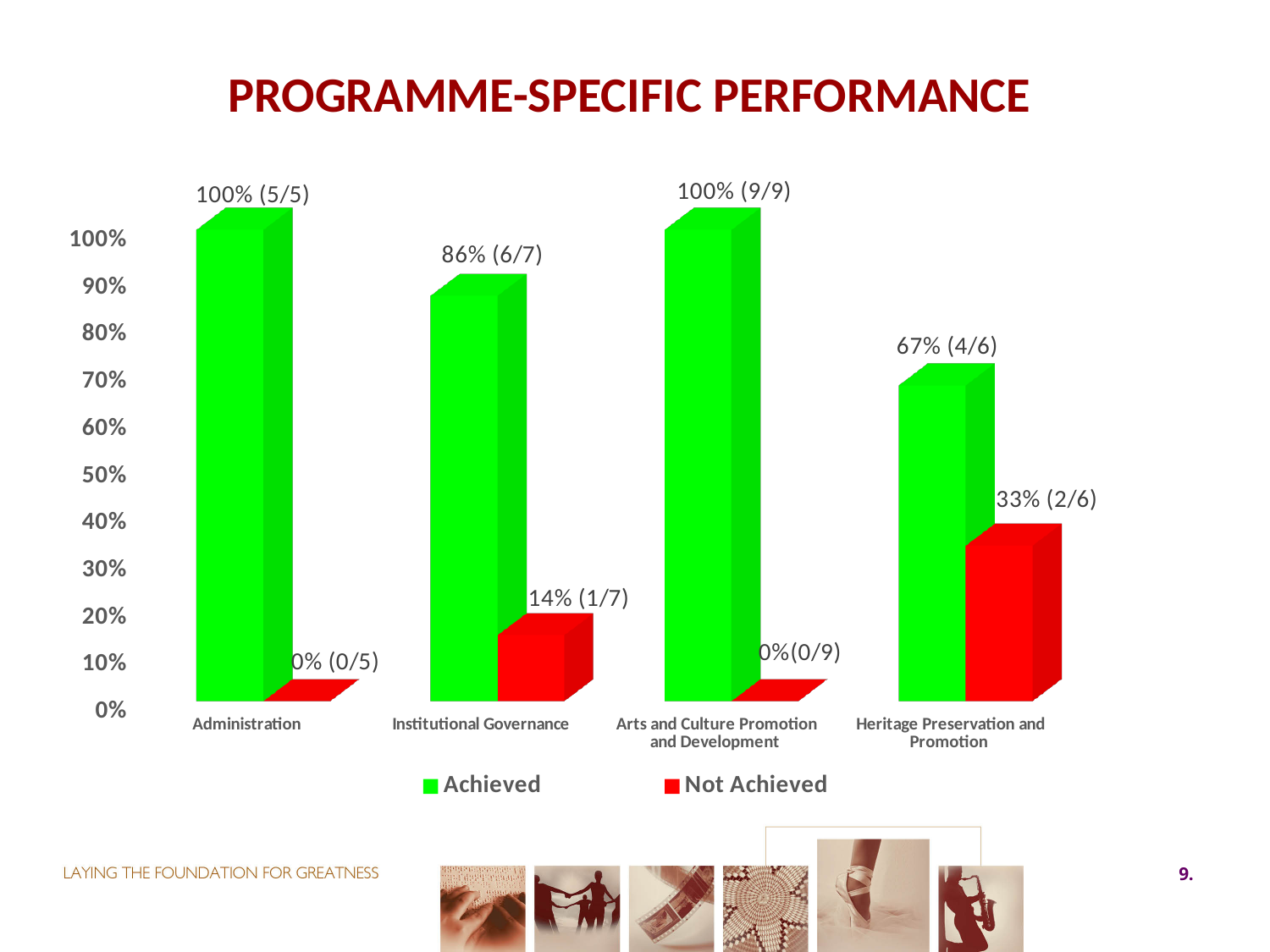
What is the Not Achieved value for Heritage Preservation and Promotion? 33% (2/6) What kind of chart is shown on the slide? Bar chart What is the Not Achieved value for Institutional Governance? 14% (1/7) What is the Achieved value for Heritage Preservation and Promotion? 67% (4/6) How many series does the legend list? 2 Which programme has the lowest Achieved percentage? Heritage Preservation and Promotion How many programmes (categories) are shown on the x axis? 4 What is the Achieved value for Institutional Governance? 86% (6/7) Which programme has the highest Not Achieved percentage? Heritage Preservation and Promotion What is the difference in Achieved percentage between Administration and Institutional Governance? 14% What colour represents the Not Achieved series? Red Which is larger, the Achieved value for Institutional Governance or the Achieved value for Heritage Preservation and Promotion? Institutional Governance